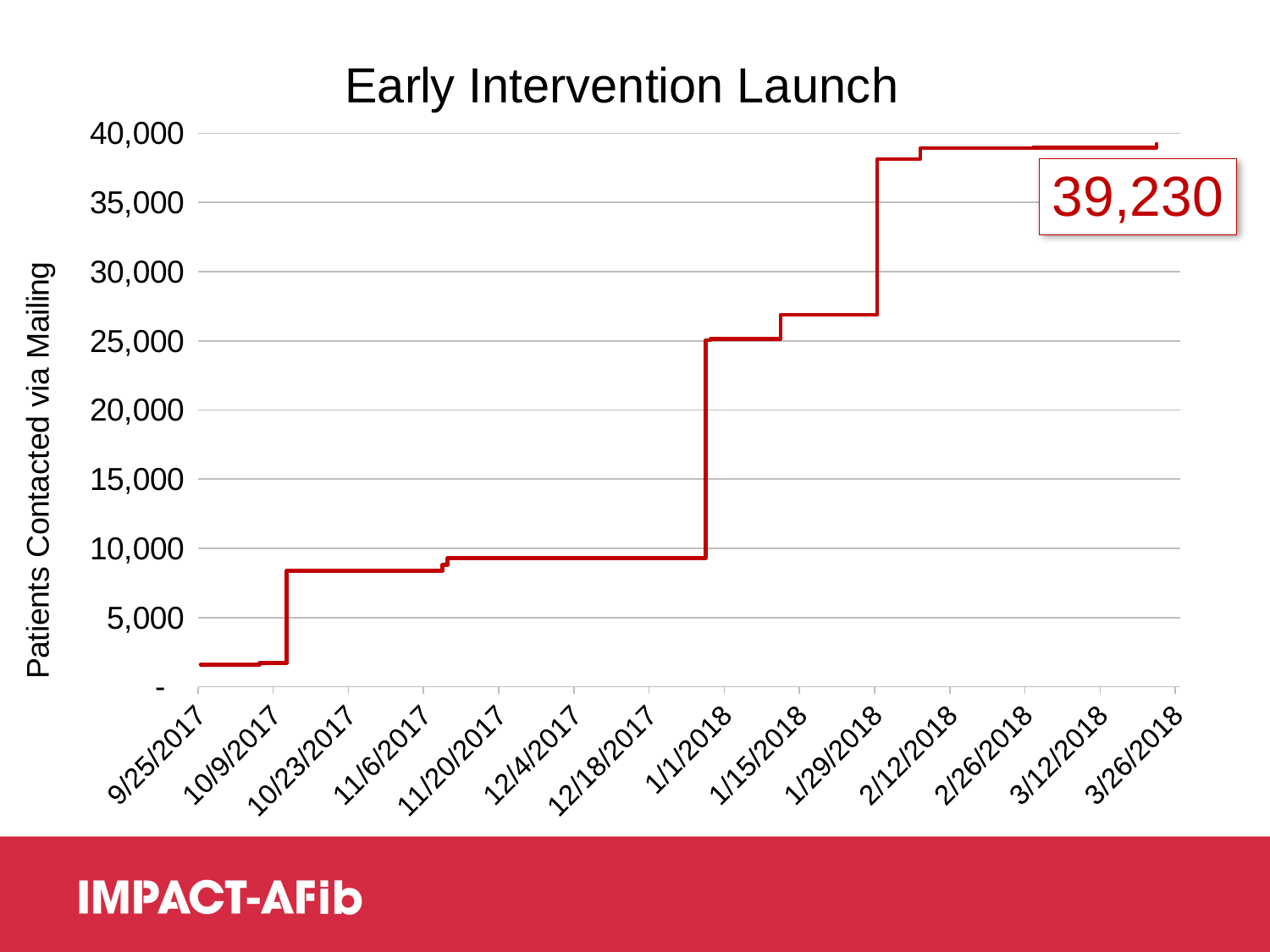
What is the label on the vertical axis of the chart? Patients Contacted via Mailing How many date labels are shown on the x axis? 14 Which date has the larger value, 12/18/2017 or 1/15/2018? 1/15/2018 Is the value for 9/25/2017 greater or less than 5,000? less Is the value for 2/12/2018 greater or less than 35,000? greater Is the value for 12/4/2017 greater or less than 10,000? less Do the values rise or fall along the x axis from 9/25/2017 to 3/26/2018? rise What value is printed as the data label at the end of the line? 39,230 What kind of chart is shown on the slide? line chart What is the title of the chart? Early Intervention Launch